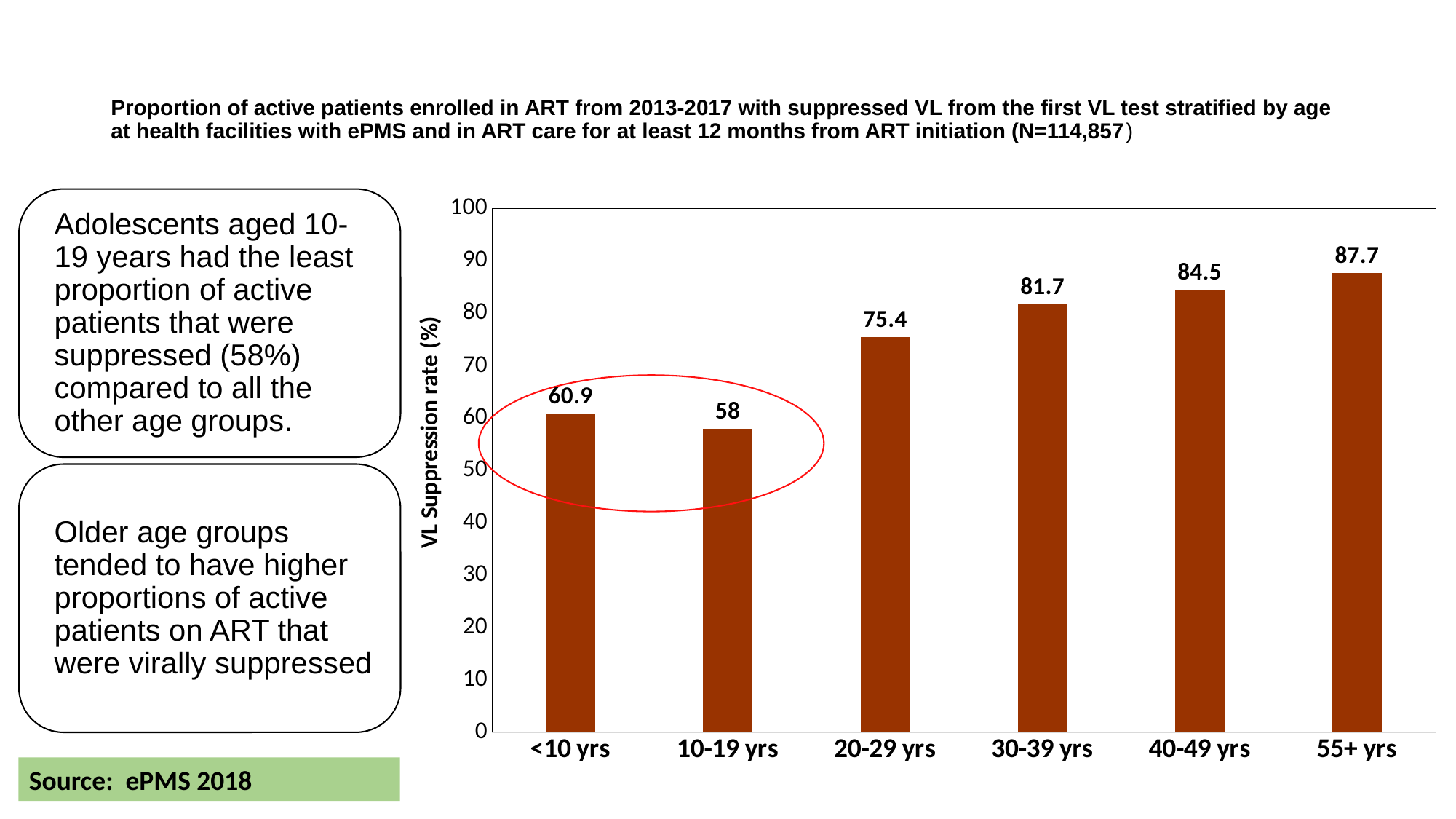
What is the difference in VL suppression rate between the <10 yrs and 10-19 yrs age groups? 2.9 How many age groups are shown on the chart? 6 What is the VL suppression rate for the 55+ yrs age group? 87.7 Which has a higher VL suppression rate, 20-29 yrs or 40-49 yrs? 40-49 yrs What is the label of the vertical axis of the chart? VL Suppression rate (%) What is the difference in VL suppression rate between the 55+ yrs and 10-19 yrs age groups? 29.7 What is the VL suppression rate for the 10-19 yrs age group? 58 Is the VL suppression rate for the 20-29 yrs age group greater or less than 70? greater What is the VL suppression rate for the 30-39 yrs age group? 81.7 What kind of chart is shown on the slide? Bar chart Which age group has the lowest VL suppression rate? 10-19 yrs Which age group has the highest VL suppression rate? 55+ yrs